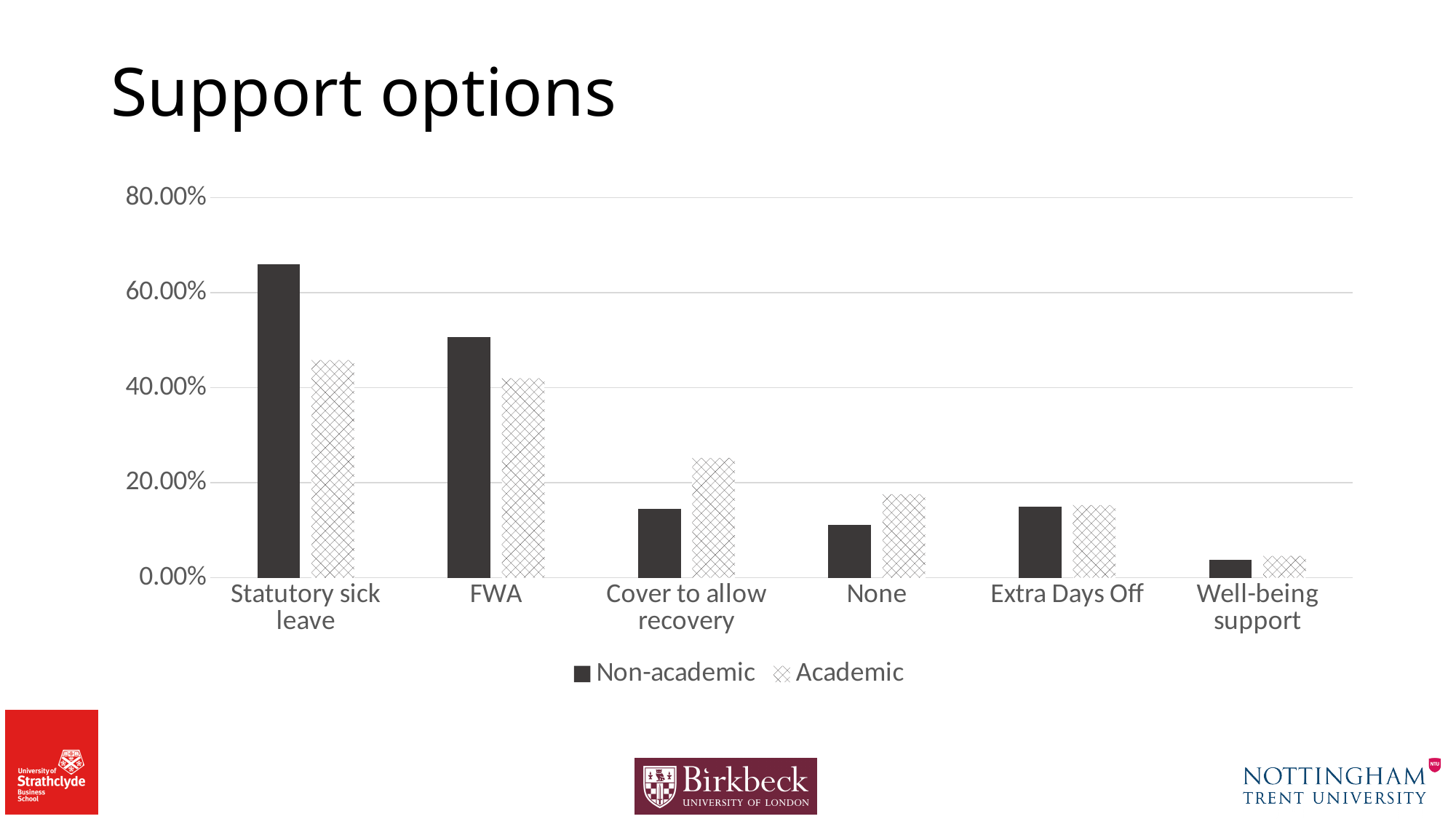
Which category has the lowest Non-academic value? Well-being support What kind of chart is shown on the slide? bar chart How many support option categories are shown on the x axis? 6 How many series does the legend list? 2 Which category has the highest Academic value? Statutory sick leave Is the Non-academic value for Statutory sick leave greater or less than 60.00%? greater Is the Academic value for Statutory sick leave greater or less than 40.00%? greater For FWA, which series has the larger value, Non-academic or Academic? Non-academic Which category has the lowest Academic value? Well-being support Which category has the highest Non-academic value? Statutory sick leave For Cover to allow recovery, which series has the larger value, Non-academic or Academic? Academic Is the Non-academic value for None greater or less than 20.00%? less